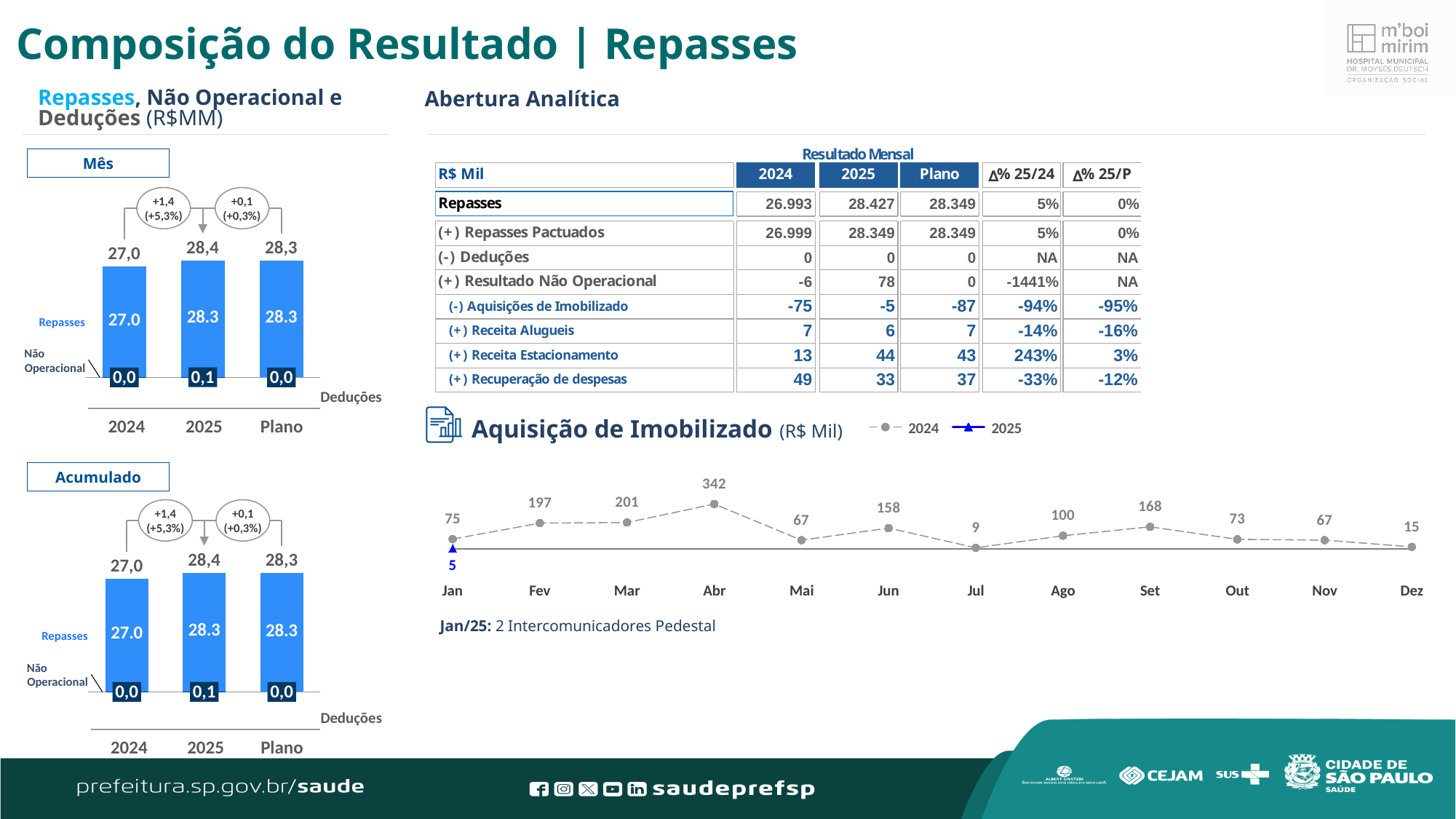
In the Mês bar chart, what is the Repasses value for 2025? 28.3 How many series does the legend of the Aquisição de Imobilizado chart list? 2 In the Aquisição de Imobilizado line chart, which month has the highest 2024 value? Abr In the Aquisição de Imobilizado line chart, what is the 2024 value for Abr? 342 In the Aquisição de Imobilizado line chart, what is the 2025 value for Jan? 5 In the Aquisição de Imobilizado line chart, what is the difference between the 2024 values for Mar and Fev? 4 In the Aquisição de Imobilizado line chart, do the 2024 values rise or fall from Set to Dez? Fall How many months are shown on the x axis of the Aquisição de Imobilizado chart? 12 In the Aquisição de Imobilizado line chart, which month has the lowest 2024 value? Jul In the Acumulado bar chart, what is the Não Operacional value for 2025? 0,1 In the Aquisição de Imobilizado line chart, which is larger, the 2024 value for Jun or for Set? Set What kind of chart is the Aquisição de Imobilizado chart? Line chart